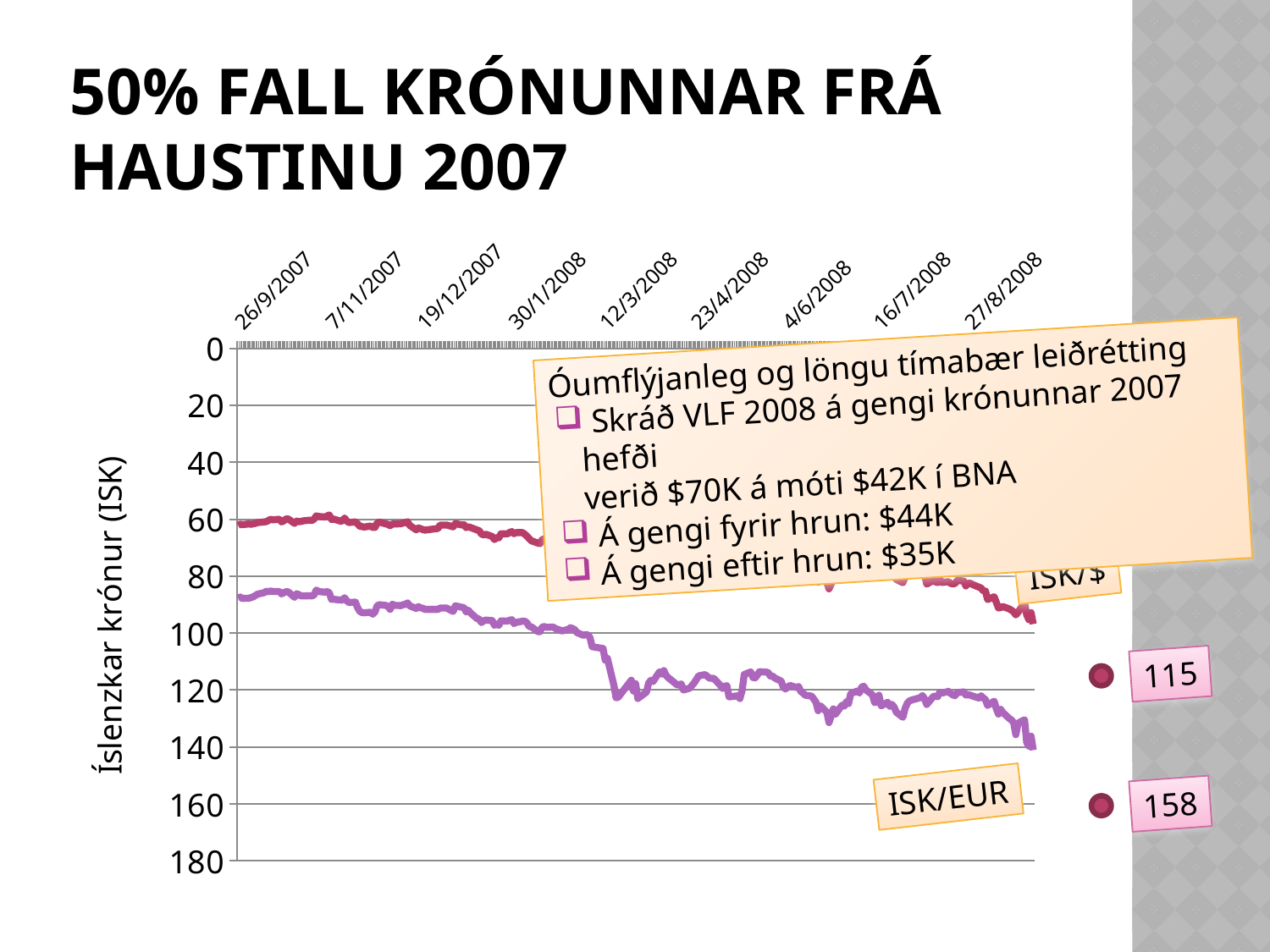
Is the ISK/EUR value at 26/9/2007 greater or less than 100? less How many series (lines) are plotted on the chart? 2 Which series has the higher value at 27/8/2008, ISK/$ or ISK/EUR? ISK/EUR Reading the values off the vertical axis, do the ISK/$ values rise or fall from 26/9/2007 to 27/8/2008? rise How many date labels are shown along the x axis? 9 Reading the values off the vertical axis, do the ISK/EUR values rise or fall from 26/9/2007 to 27/8/2008? rise Is the ISK/$ value at 26/9/2007 greater or less than 80? less What are the names of the two series plotted on the chart? ISK/$ and ISK/EUR What is the label of the vertical axis? Íslenzkar krónur (ISK) What kind of chart is shown on the slide? line chart